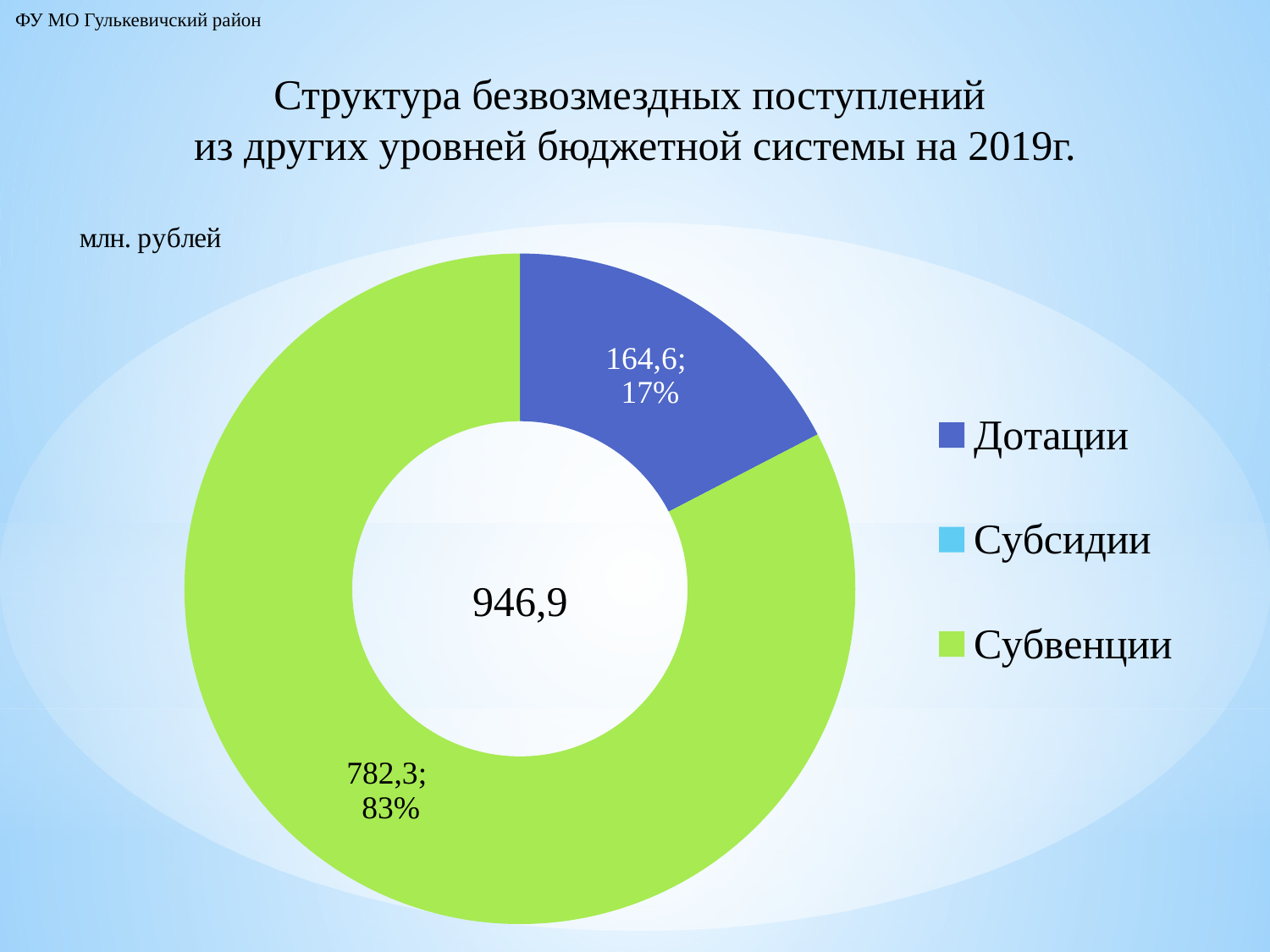
Which is larger, the value for Дотации or the value for Субвенции? Субвенции What unit is indicated for the chart values? млн. рублей What is the value for Субвенции? 782,3 What total value is shown in the centre of the chart? 946,9 What kind of chart is shown on the slide? doughnut chart Which category has the largest slice? Субвенции What share of the chart does Дотации represent? 17% What is the value for Дотации? 164,6 How many entries does the legend list? 3 Which category has the smallest visible slice? Дотации What is the difference between the values for Субвенции and Дотации? 617,7 What share of the chart does Субвенции represent? 83%